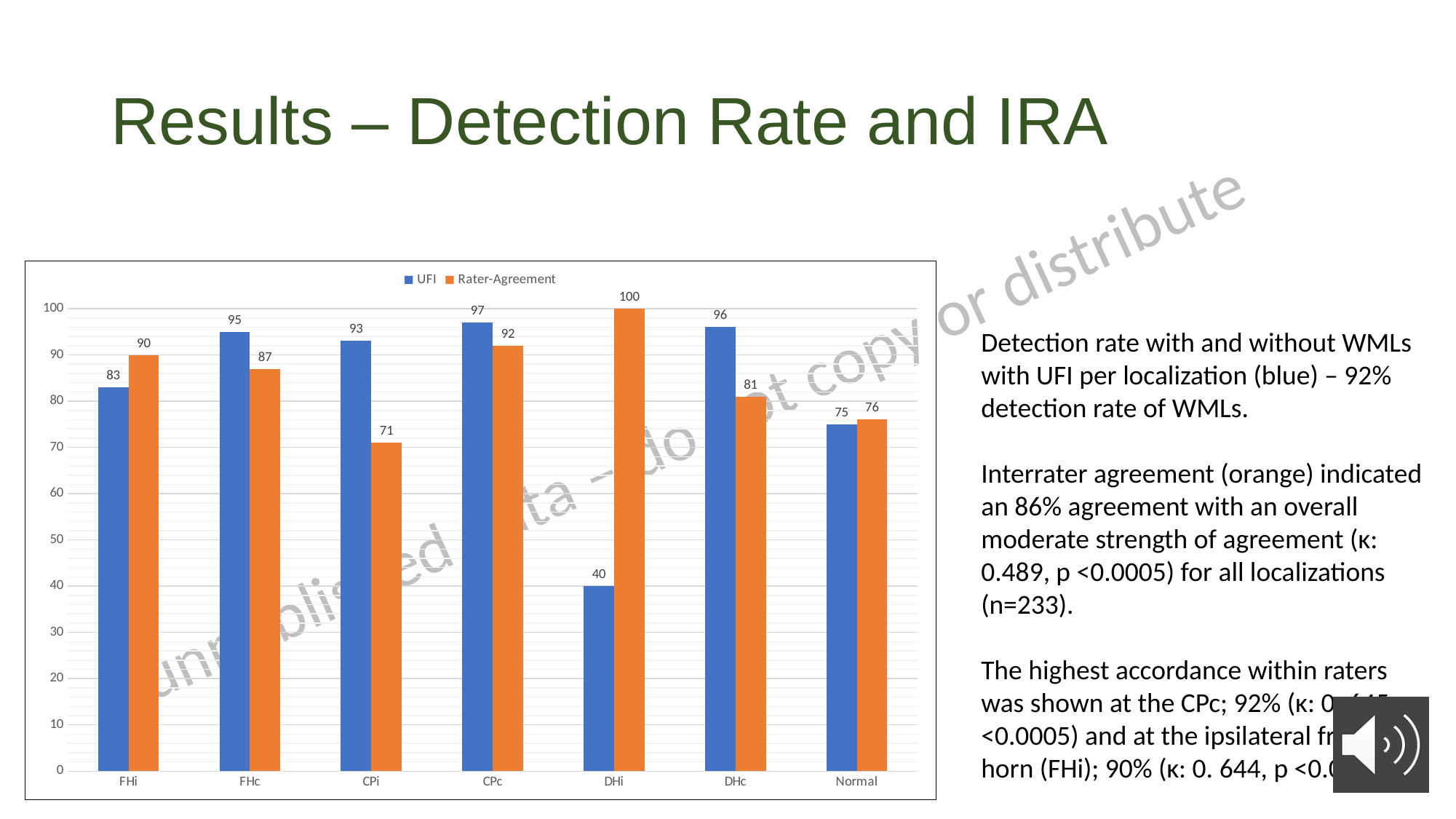
Which is larger for CPi, the UFI value or the Rater-Agreement value? UFI What is the difference between the UFI and Rater-Agreement values for DHi? 60 What is the Rater-Agreement value for DHi? 100 What is the UFI value for CPc? 97 How many series does the legend list? 2 How many categories are shown on the x axis? 7 Which category has the highest UFI value? CPc What is the UFI value for DHi? 40 What is the Rater-Agreement value for CPi? 71 Which category has the lowest Rater-Agreement value? CPi What kind of chart is shown on the slide? Bar chart Which category has the lowest UFI value? DHi